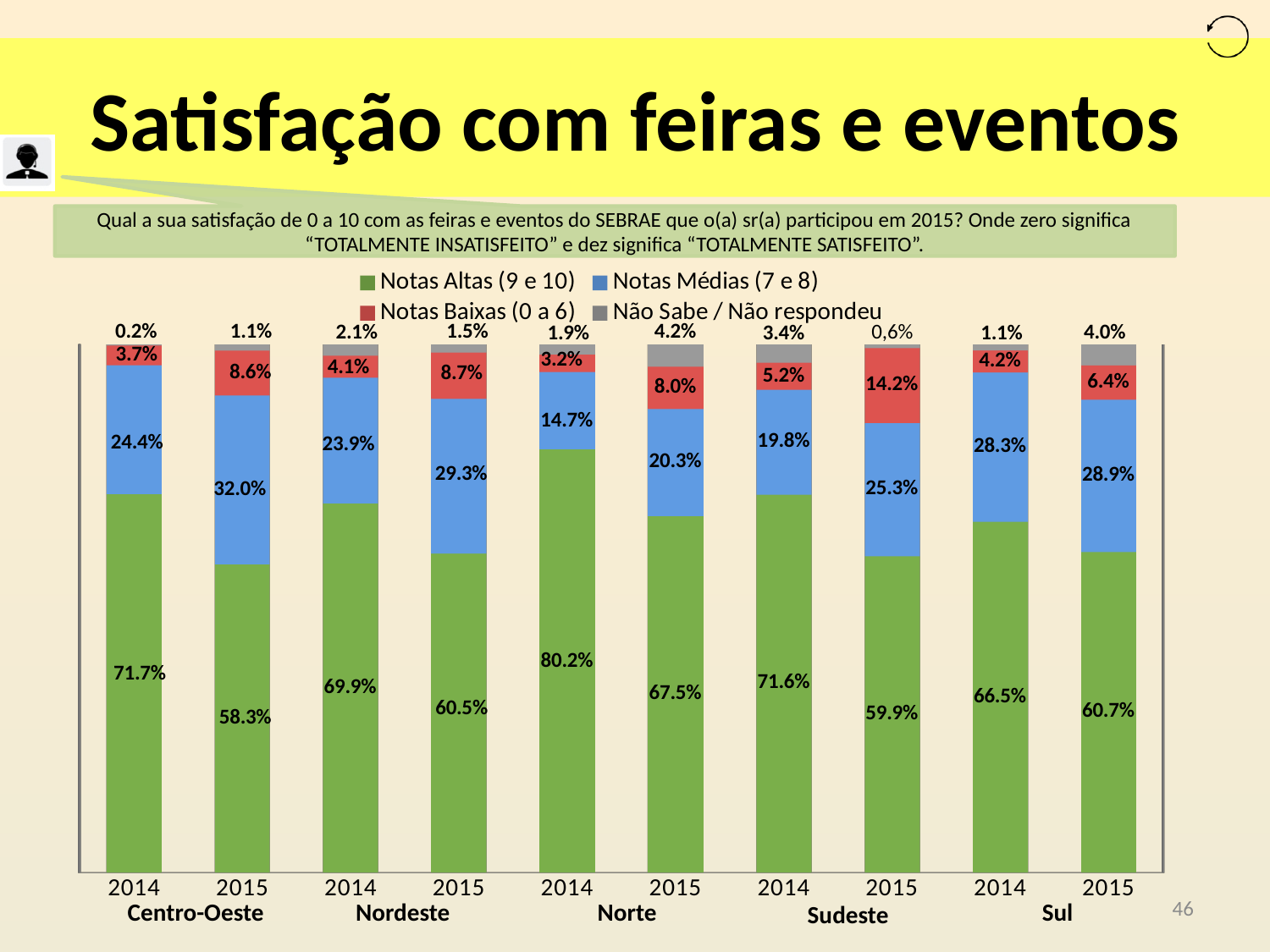
Did the Notas Altas (9 e 10) value for Nordeste rise or fall from 2014 to 2015? Fall What is the value of Notas Médias (7 e 8) for Centro-Oeste in 2015? 32.0% What is the value of Notas Altas (9 e 10) for Norte in 2014? 80.2% Which is larger, the Notas Médias (7 e 8) value for Sul in 2014 or for Sul in 2015? Sul 2015 How many series does the legend list? 4 How many bars are plotted in the chart? 10 What kind of chart is shown on the slide? Stacked bar chart Which bar has the lowest value for Notas Altas (9 e 10)? Centro-Oeste 2015 What is the difference between the Notas Altas (9 e 10) values for Centro-Oeste in 2014 and 2015? 13.4 percentage points What is the value of Não Sabe / Não respondeu for Norte in 2015? 4.2% What is the value of Notas Baixas (0 a 6) for Sudeste in 2015? 14.2% Which bar has the highest value for Notas Altas (9 e 10)? Norte 2014